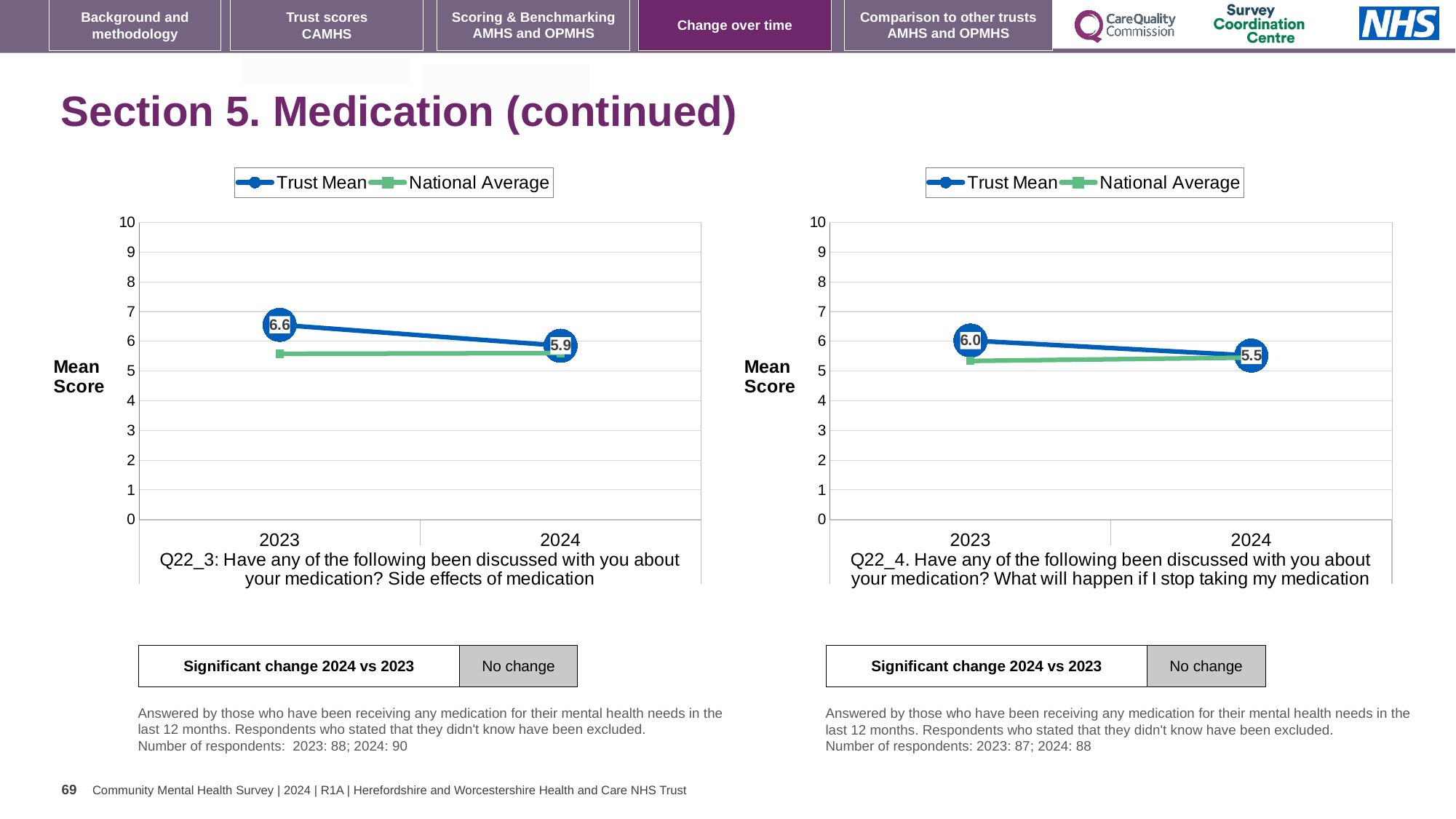
In the right chart (Q22_4), what is the difference between the Trust Mean in 2023 and 2024? 0.5 In the right chart (Q22_4), what is the Trust Mean score for 2024? 5.5 In the left chart (Q22_3), does the Trust Mean rise or fall from 2023 to 2024? fall What type of chart is used on the right side of the slide (Q22_4)? line chart In the right chart (Q22_4), what is the Trust Mean score for 2023? 6.0 In the left chart (Q22_3), by how much did the Trust Mean fall from 2023 to 2024? 0.7 In the right chart (Q22_4), is the National Average for 2023 greater or less than 6? less In the left chart (Q22_3), what is the Trust Mean score for 2024? 5.9 How many series does the legend of the left chart list? 2 In the right chart (Q22_4), which year has the higher Trust Mean score? 2023 In the left chart (Q22_3), is the Trust Mean or the National Average higher in 2023? Trust Mean In the left chart (Q22_3), what is the Trust Mean score for 2023? 6.6